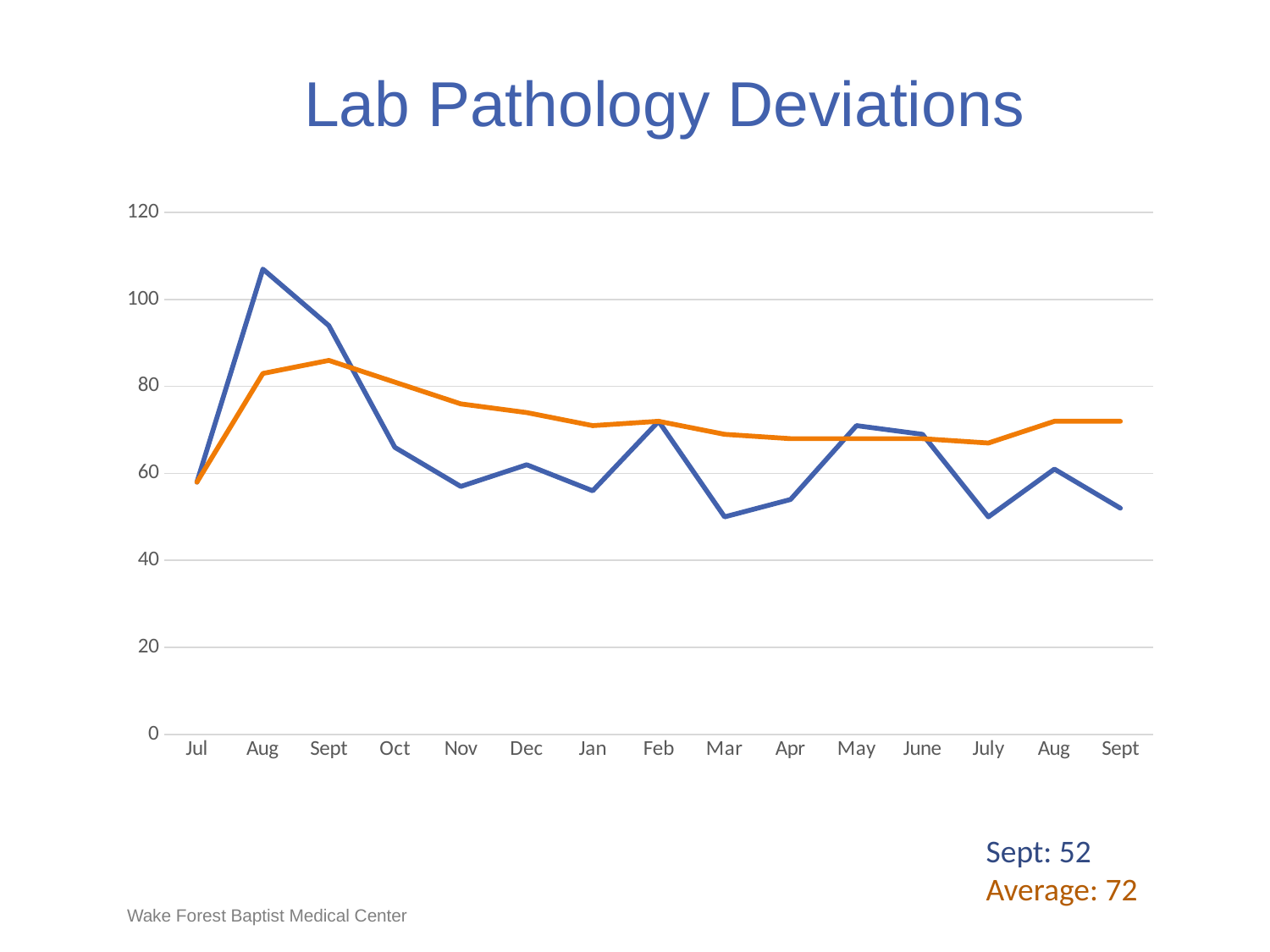
At Oct, which line is higher, the blue line or the orange line? orange Is the blue line's value for the first Aug greater or less than 100? greater What is the title of the chart? Lab Pathology Deviations What is the value of the blue line for the final Sept? 52 In which month is the orange average line at its lowest? Jul How many months are plotted along the x axis? 15 What is the value of the orange average line for the final Sept? 72 How many lines are plotted on the chart? 2 In which month does the blue line reach its highest value? Aug What is the difference between the average (72) and the final Sept value (52)? 20 What kind of chart is shown on the slide? line chart Is the blue line's value for Mar greater or less than 60? less